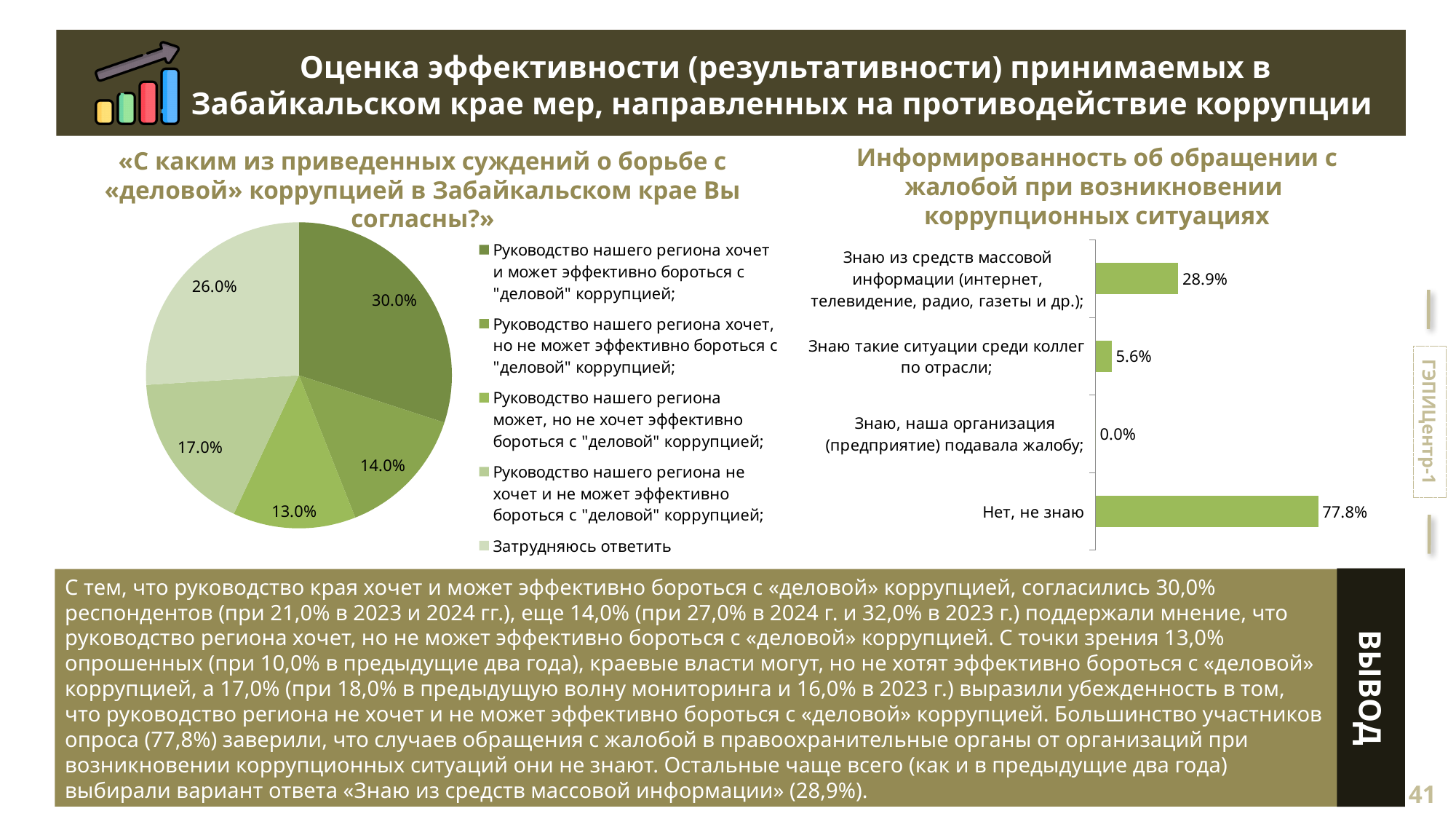
On the bar chart on the right, what is the difference between "Нет, не знаю" and "Знаю из средств массовой информации"? 48.9% On the bar chart on the right ("Информированность об обращении с жалобой..."), what is the value for "Нет, не знаю"? 77.8% What type of chart is shown on the right side of the slide? Bar chart On the pie chart on the left, how many slices does the pie have? 5 On the bar chart on the right, how many categories are shown? 4 On the pie chart on the left, what share of respondents chose "Затрудняюсь ответить"? 26.0% On the pie chart on the left, which answer option has the smallest share? Руководство нашего региона может, но не хочет эффективно бороться с "деловой" коррупцией On the bar chart on the right, what is the value for "Знаю такие ситуации среди коллег по отрасли"? 5.6% On the pie chart on the left, what is the difference between the 30.0% slice and the 14.0% slice? 16.0% On the pie chart on the left, which answer option has the largest share? Руководство нашего региона хочет и может эффективно бороться с "деловой" коррупцией On the pie chart on the left, what share of respondents agreed that the regional leadership wants and can effectively fight "business" corruption ("Руководство нашего региона хочет и может эффективно бороться")? 30.0% On the bar chart on the right, which category has the lowest value? Знаю, наша организация (предприятие) подавала жалобу